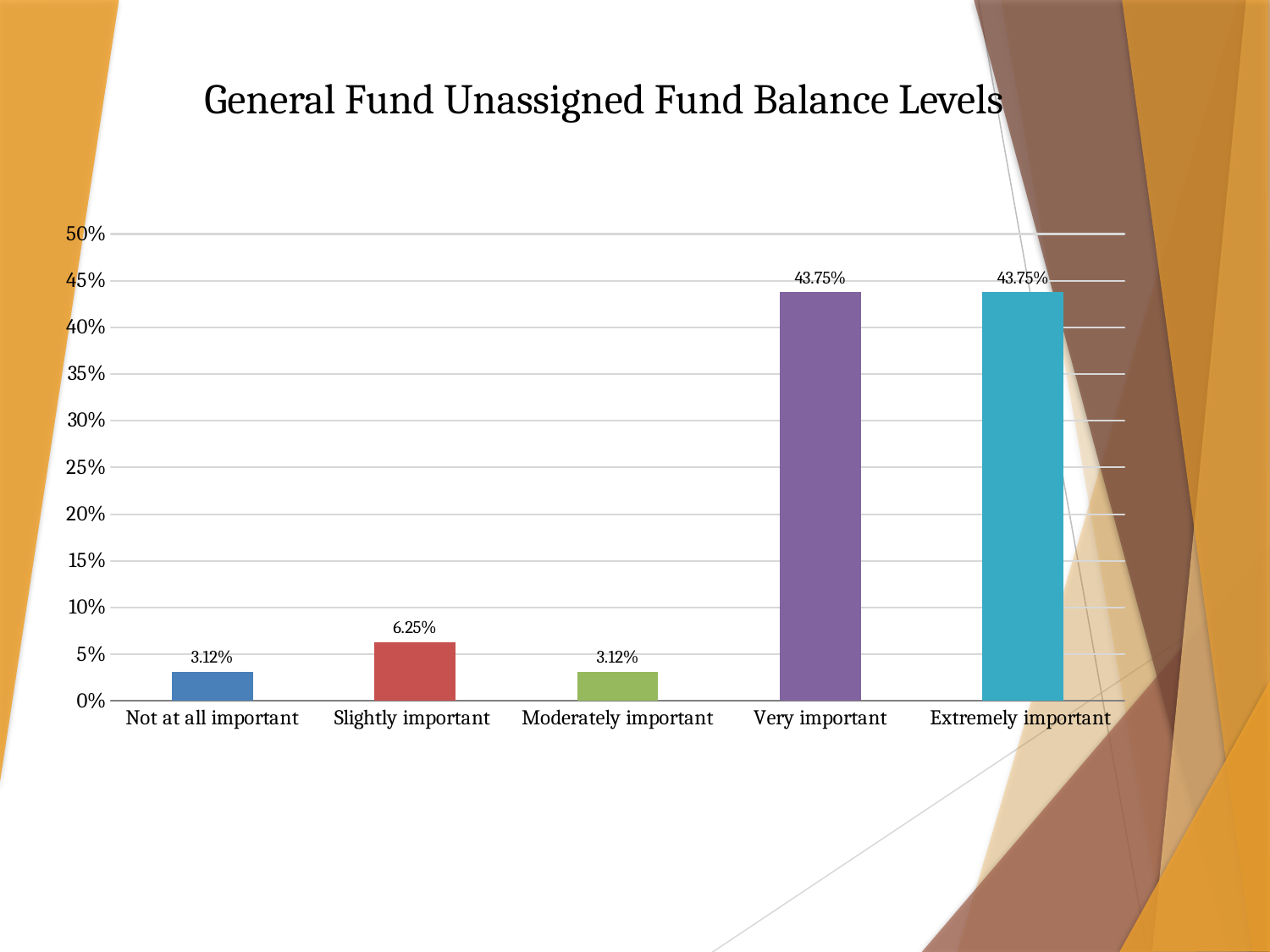
What is the difference between the values for Very important and Slightly important? 37.5% What is the value for Not at all important? 3.12% What is the difference between the values for Slightly important and Not at all important? 3.13% Is the value for Extremely important greater or less than 40%? greater What is the title of the chart? General Fund Unassigned Fund Balance Levels What is the value for Very important? 43.75% What is the value for Slightly important? 6.25% Is the value for Slightly important greater or less than 10%? less What kind of chart is shown on the slide? bar chart How many categories are shown on the x axis? 5 Which category has the lowest value, Slightly important or Moderately important? Moderately important What is the value for Moderately important? 3.12%